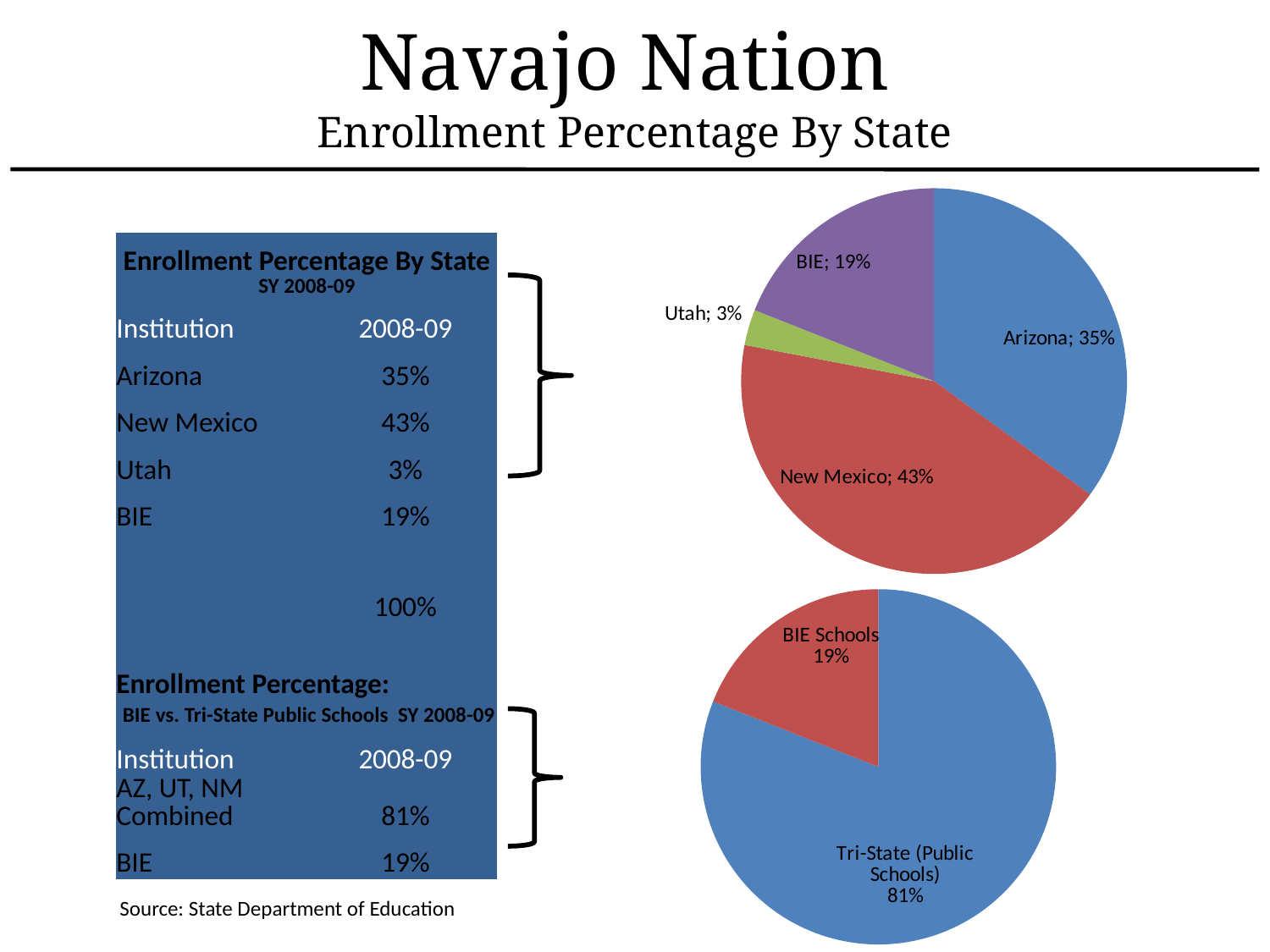
In the top pie chart, which category has the largest share? New Mexico What kind of chart is the bottom chart on the slide? Pie chart In the top pie chart, which is larger, the share for BIE or the share for Utah? BIE How many slices does the top pie chart have? 4 In the top pie chart, what is the share for Utah? 3% In the top pie chart, what is the difference between the New Mexico and Arizona shares? 8% In the bottom pie chart, what is the share for BIE Schools? 19% In the top pie chart, what is the share for Arizona? 35% In the top pie chart, what is the share for New Mexico? 43% In the top pie chart, which category has the smallest share? Utah In the bottom pie chart, what is the difference between the Tri-State (Public Schools) share and the BIE Schools share? 62% In the bottom pie chart, what is the share for Tri-State (Public Schools)? 81%